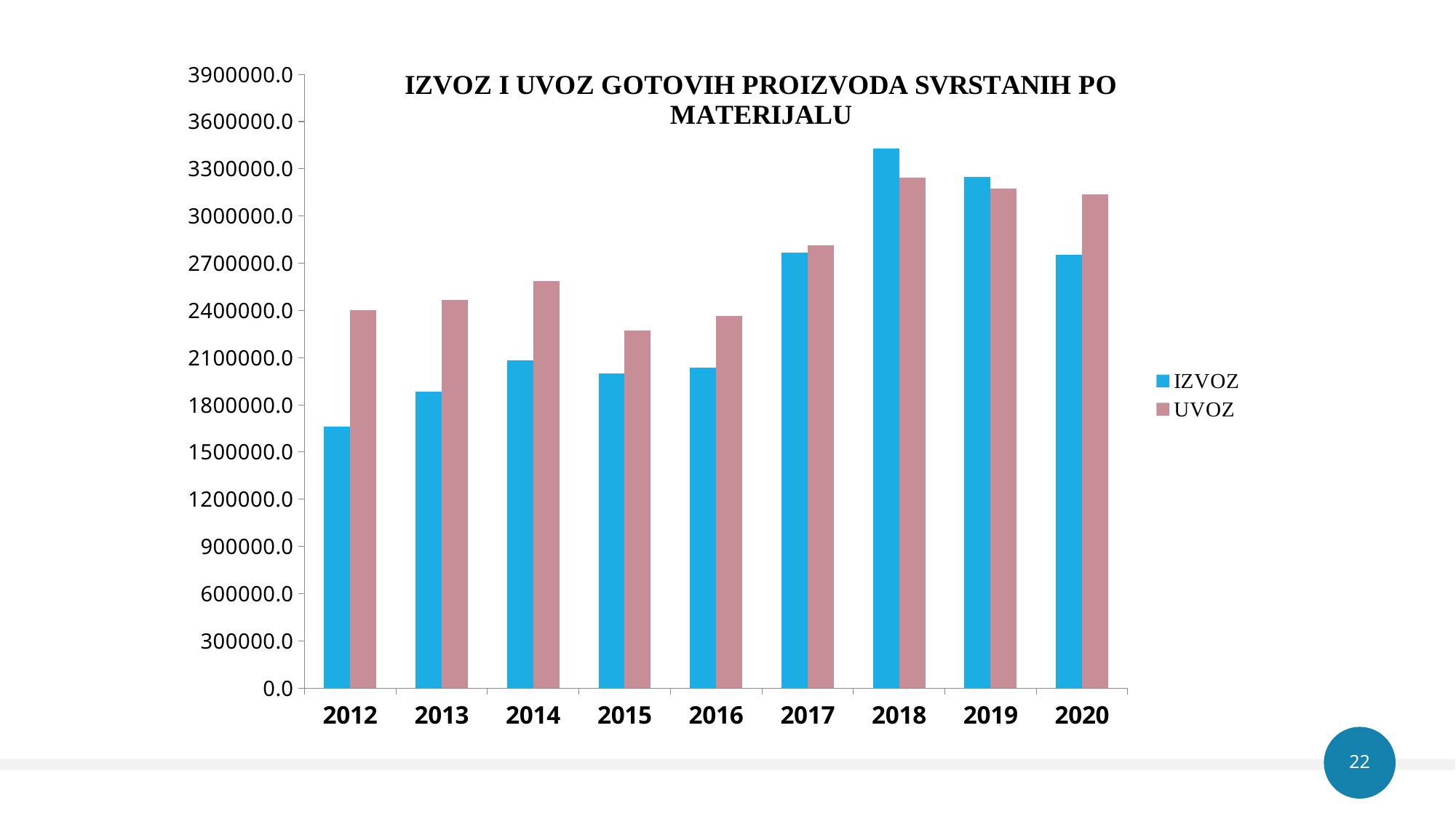
Is the IZVOZ value for 2018 greater or less than 3300000.0? greater How many years are shown on the x axis? 9 In which year is the IZVOZ value lowest? 2012 In which year is the UVOZ value highest? 2018 In which year is the IZVOZ value highest? 2018 Which series is shown in blue? IZVOZ Does the IZVOZ value rise or fall from 2016 to 2018? rise How many series does the legend list? 2 In 2012, which is larger, IZVOZ or UVOZ? UVOZ In 2018, which is larger, IZVOZ or UVOZ? IZVOZ Is the IZVOZ value for 2012 greater or less than 1800000.0? less What kind of chart is shown on the slide? bar chart